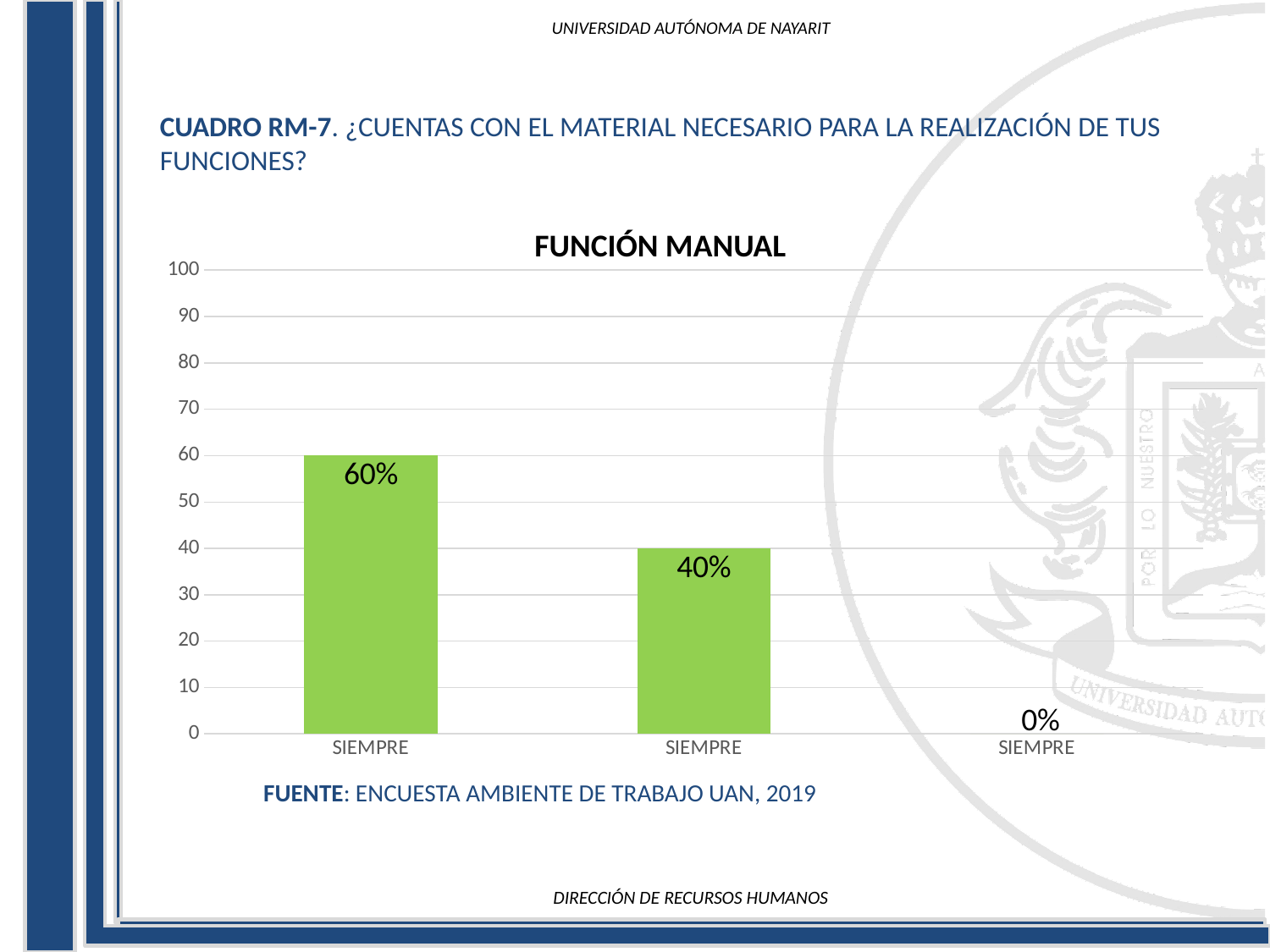
Do the values rise or fall from left to right across the chart? fall What is the value shown for the rightmost category of the chart? 0% What is the title of the chart? FUNCIÓN MANUAL What type of chart is shown on the slide? bar chart What is the value shown on the leftmost bar of the chart? 60% Which bar has the highest value in the chart? the leftmost bar (60%) Which is larger, the leftmost bar or the middle bar? the leftmost bar What is the difference between the leftmost bar and the middle bar? 20% How many bars (categories) are plotted in the chart? 3 What is the value shown on the middle bar of the chart? 40% What label appears under each of the three bars on the x axis? SIEMPRE Which category has the lowest value in the chart? the rightmost category (0%)